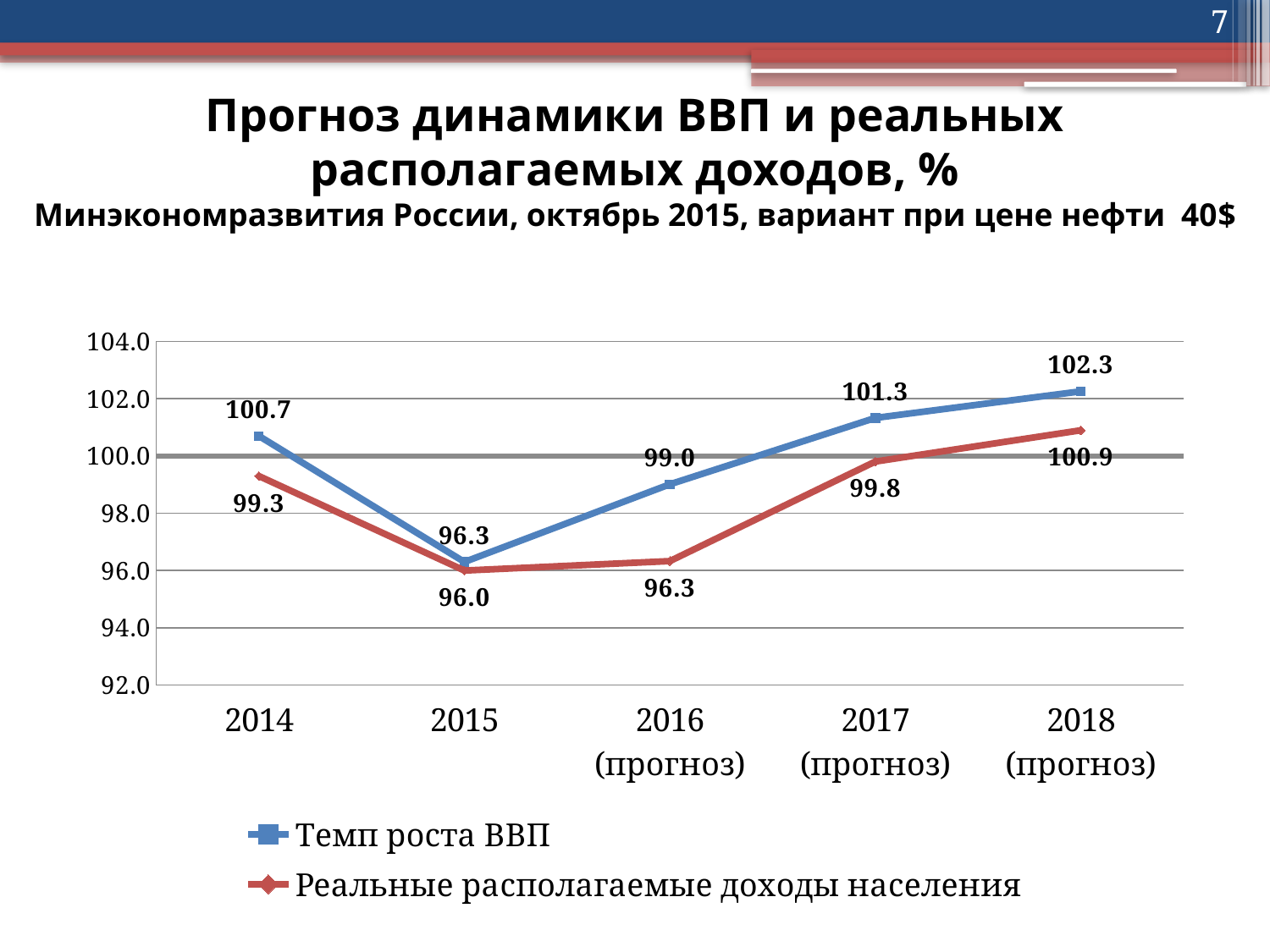
What colour is the line for Реальные располагаемые доходы населения? Red What is the value of Реальные располагаемые доходы населения in 2016 (прогноз)? 96.3 How many years are plotted along the x axis? 5 How many series does the legend list? 2 In which year is Темп роста ВВП highest? 2018 (прогноз) How does Темп роста ВВП change from 2015 to 2018 (прогноз)? It rises What type of chart is shown on the slide? Line chart What is the difference between Темп роста ВВП and Реальные располагаемые доходы населения in 2016 (прогноз)? 2.7 What is the value of Темп роста ВВП in 2014? 100.7 In which year is Реальные располагаемые доходы населения lowest? 2015 What is the value of Темп роста ВВП in 2018 (прогноз)? 102.3 Which series has the larger value in 2017 (прогноз): Темп роста ВВП or Реальные располагаемые доходы населения? Темп роста ВВП